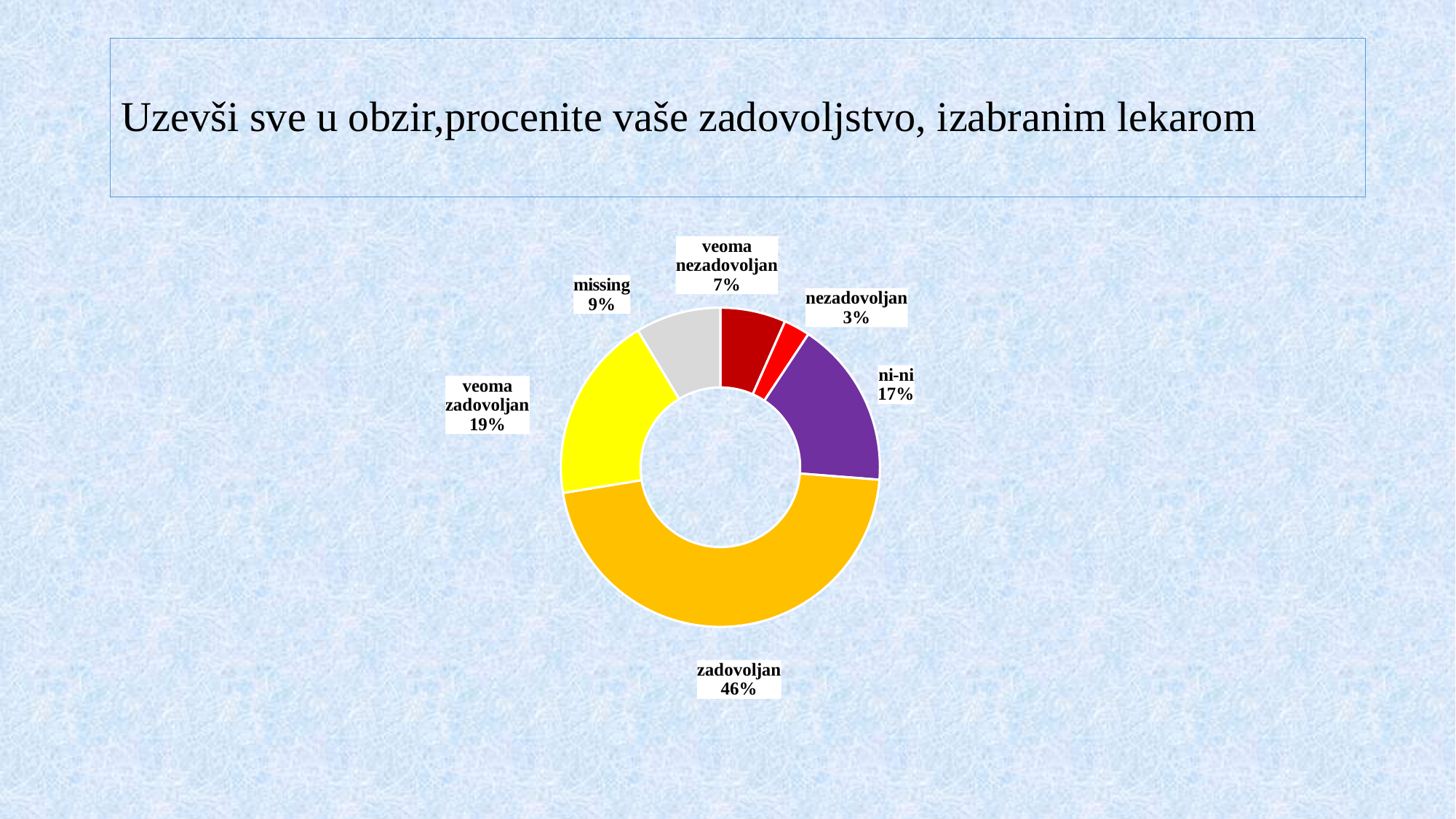
What percentage is shown for 'ni-ni'? 17% Which is larger, 'ni-ni' or 'missing'? ni-ni What kind of chart is shown on the slide? Doughnut (pie) chart What percentage is shown for 'veoma nezadovoljan'? 7% Which category has the smallest share? nezadovoljan What share of the chart does the 'zadovoljan' slice represent? 46% What percentage is shown for 'missing'? 9% How many categories are shown in the chart? 6 What colour is the 'zadovoljan' slice? Orange What is the difference in percentage points between 'zadovoljan' and 'veoma zadovoljan'? 27 Which category has the largest share? zadovoljan What percentage is shown for 'veoma zadovoljan'? 19%